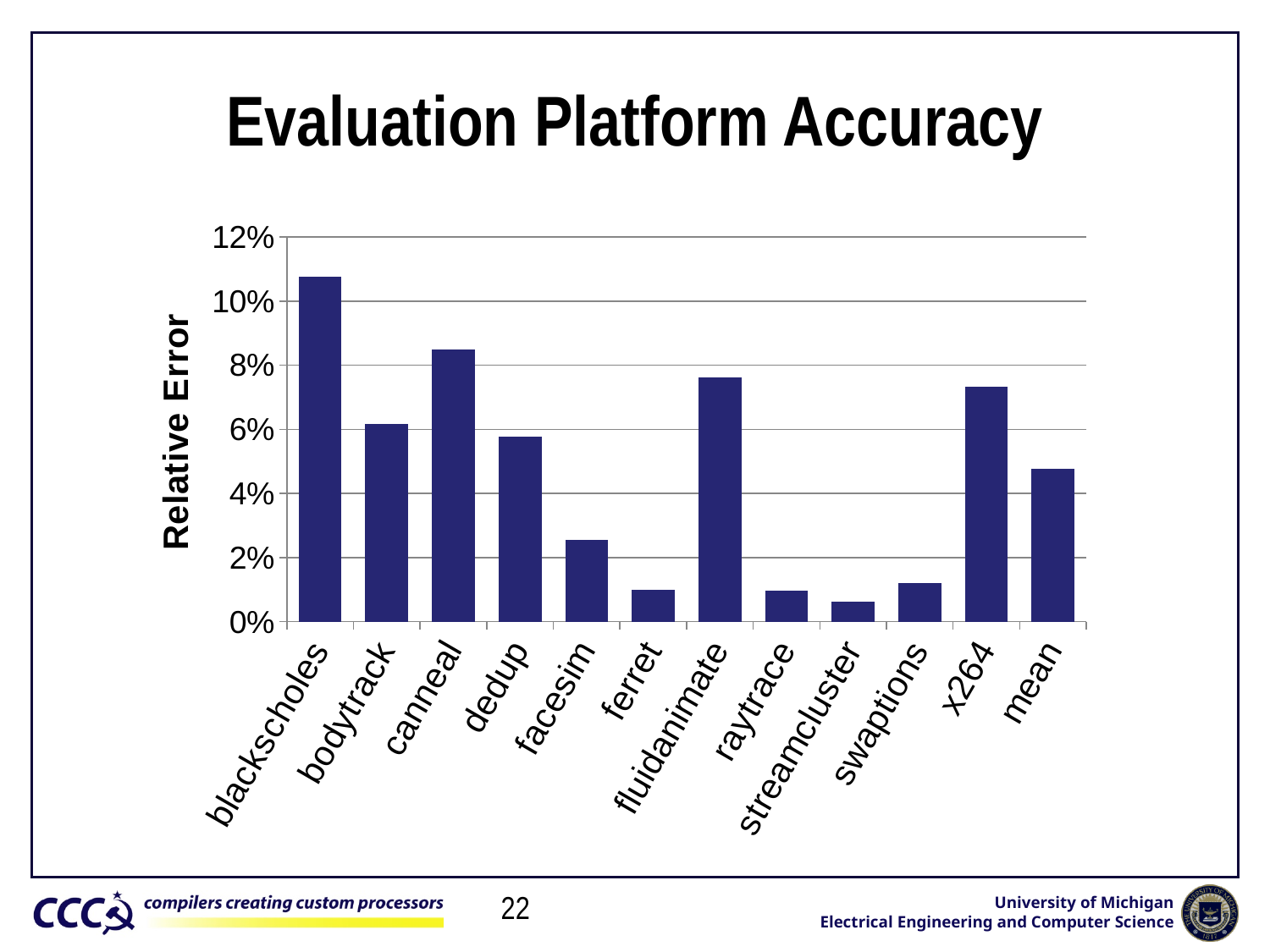
Which category has the lowest relative error? streamcluster Which has a higher relative error, facesim or swaptions? facesim Is the relative error for canneal greater or less than 8%? greater Which category has the highest relative error? blackscholes Is the relative error for x264 greater or less than 8%? less Is the relative error for facesim greater or less than 2%? greater Which has a higher relative error, canneal or fluidanimate? canneal How many categories are plotted along the x axis? 12 What kind of chart is shown on the slide? bar chart What is the label on the y axis of the chart? Relative Error